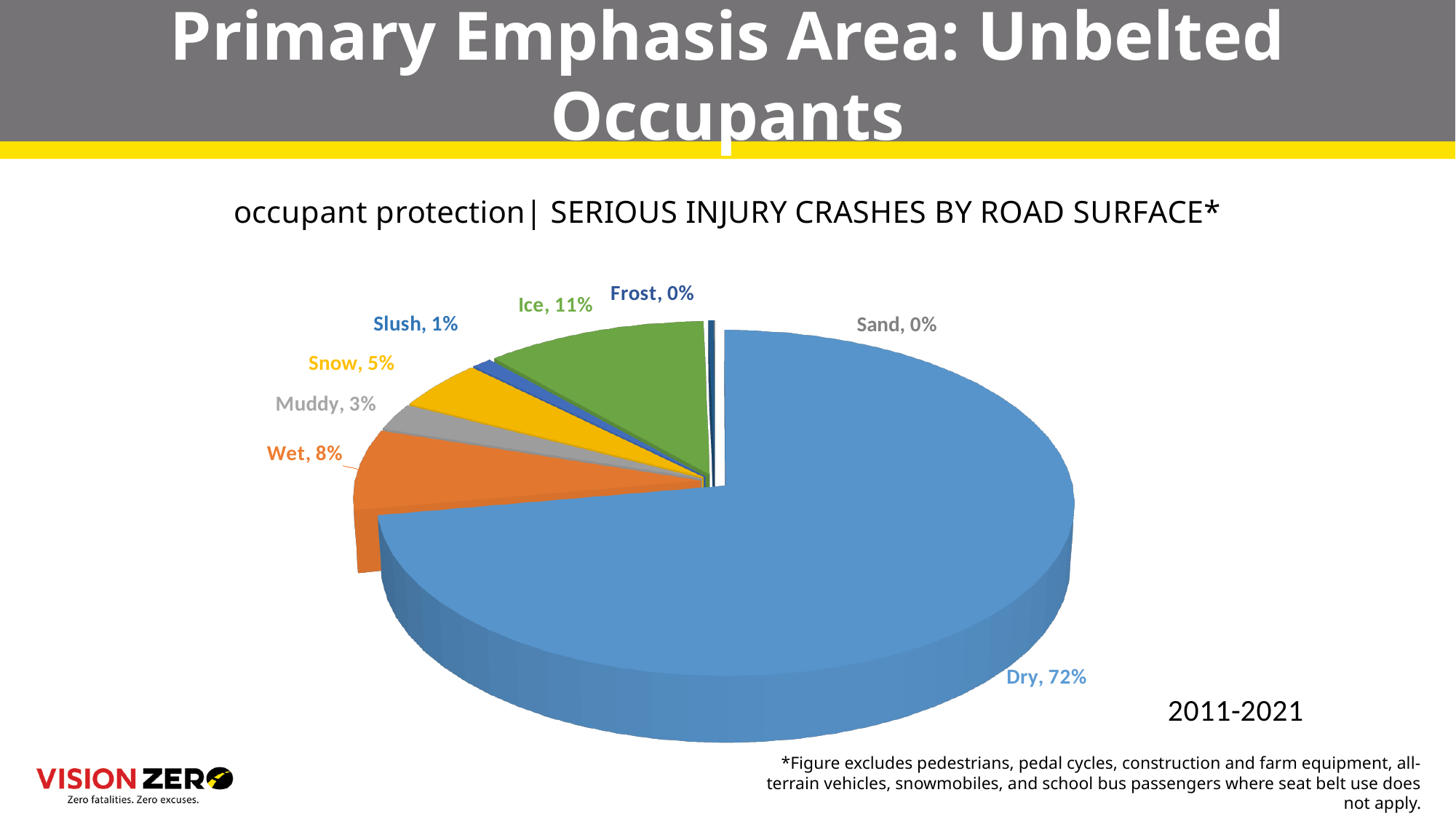
Which road surface category has the largest share of serious injury crashes? Dry How many road surface categories are shown in the pie chart? 8 What type of chart is shown on the slide? Pie chart What percentage of serious injury crashes occurred on a wet road surface? 8% What is the difference in percentage points between the Dry and Ice shares? 61 What percentage of serious injury crashes occurred on a snowy road surface? 5% What is the title of the chart? occupant protection| SERIOUS INJURY CRASHES BY ROAD SURFACE* What percentage of serious injury crashes occurred on a dry road surface? 72% What percentage of serious injury crashes occurred on an icy road surface? 11% What percentage of serious injury crashes occurred on a muddy road surface? 3% What time period does the chart cover? 2011-2021 Which has a larger share of serious injury crashes, Ice or Wet? Ice